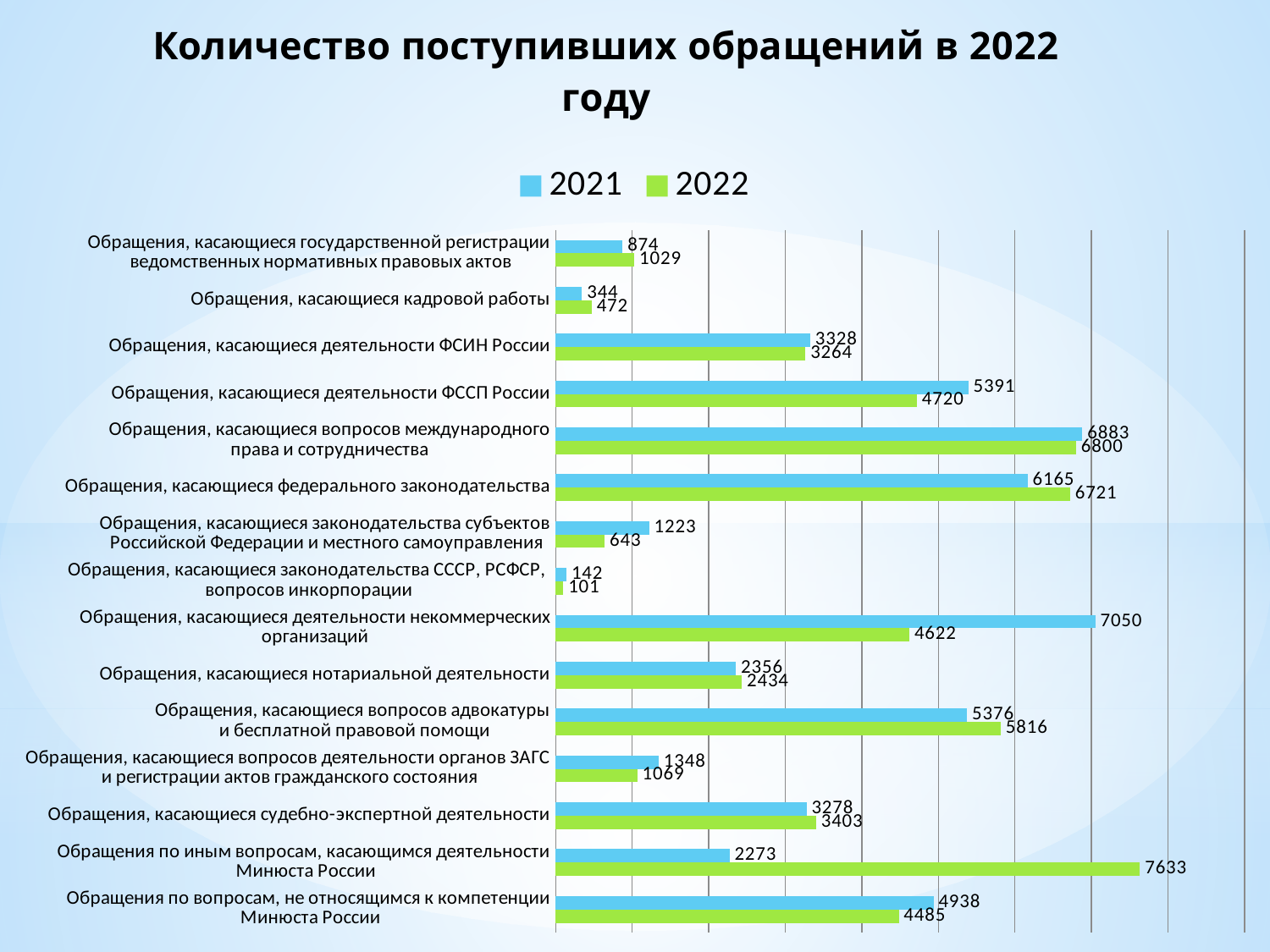
What is the difference between the 2022 and 2021 values for «Обращения по иным вопросам, касающимся деятельности Минюста России»? 5360 Which colour represents the 2022 series in the legend? green How many categories are shown on the chart? 15 How many series does the legend list? 2 For «Обращения, касающиеся федерального законодательства», which year has the larger value, 2021 or 2022? 2022 Which category has the lowest 2021 value? Обращения, касающиеся законодательства СССР, РСФСР, вопросов инкорпорации Which category has the highest 2022 value? Обращения по иным вопросам, касающимся деятельности Минюста России What is the 2021 value for «Обращения, касающиеся деятельности некоммерческих организаций»? 7050 What is the 2022 value for «Обращения, касающиеся кадровой работы»? 472 What is the difference between the 2021 and 2022 values for «Обращения, касающиеся деятельности некоммерческих организаций»? 2428 What kind of chart is shown on the slide? bar chart What is the 2022 value for «Обращения по иным вопросам, касающимся деятельности Минюста России»? 7633